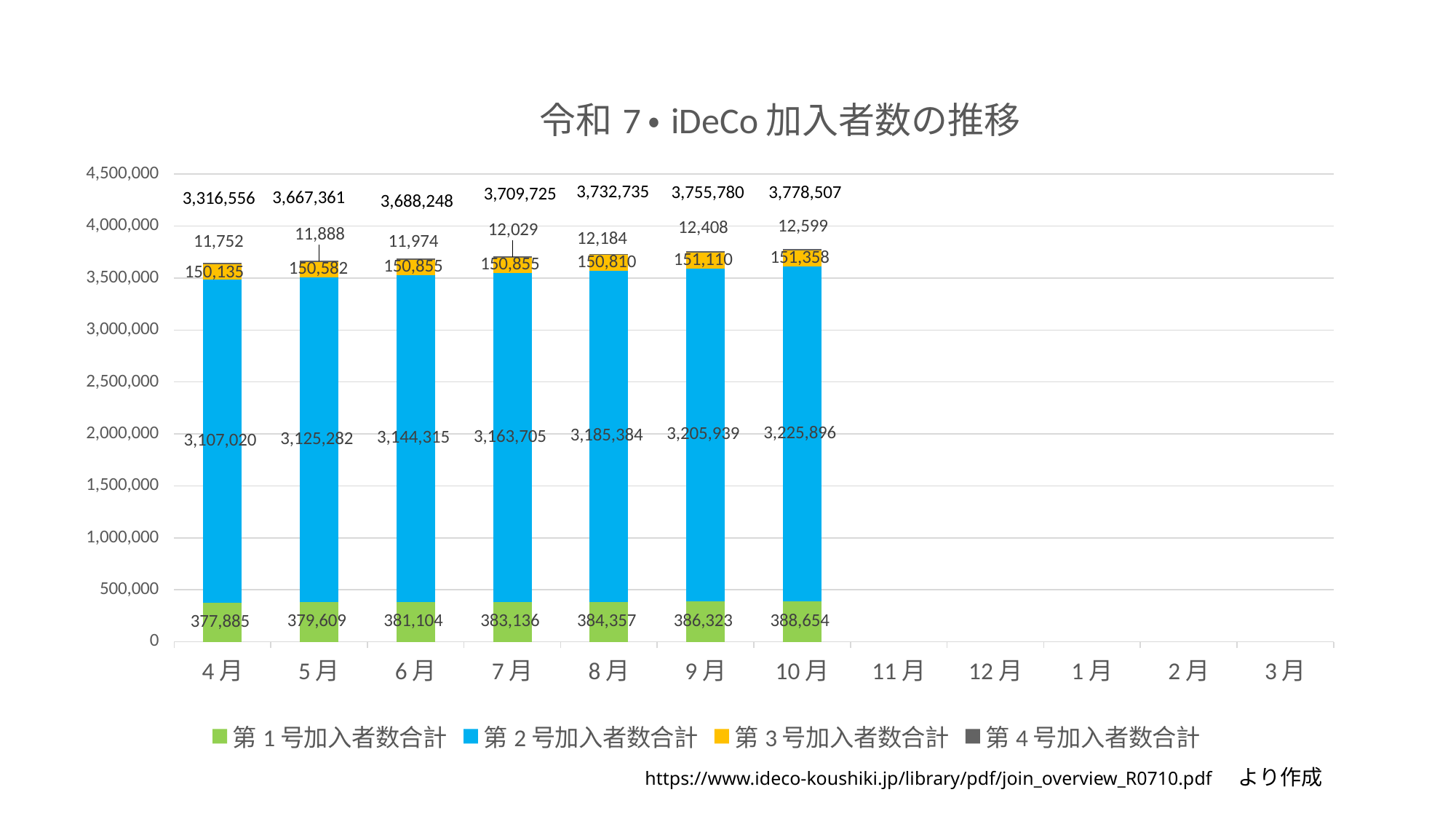
Which month has the highest value for 第2号加入者数合計? 10月 What is the value of 第4号加入者数合計 for 7月? 12,029 What is the difference between the 第1号加入者数合計 values for 10月 and 4月? 10,769 Does the value of 第2号加入者数合計 rise or fall from 4月 to 10月? Rise Which month has the lowest value for 第4号加入者数合計? 4月 What is the value of 第2号加入者数合計 for 10月? 3,225,896 What is the value of 第3号加入者数合計 for 9月? 151,110 How many series does the legend list? 4 What is the total of the stacked bar for 10月, as labelled on the chart? 3,778,507 What kind of chart is shown on the slide? Stacked bar chart How many months have bars plotted on the chart? 7 What is the value of 第1号加入者数合計 for 4月? 377,885